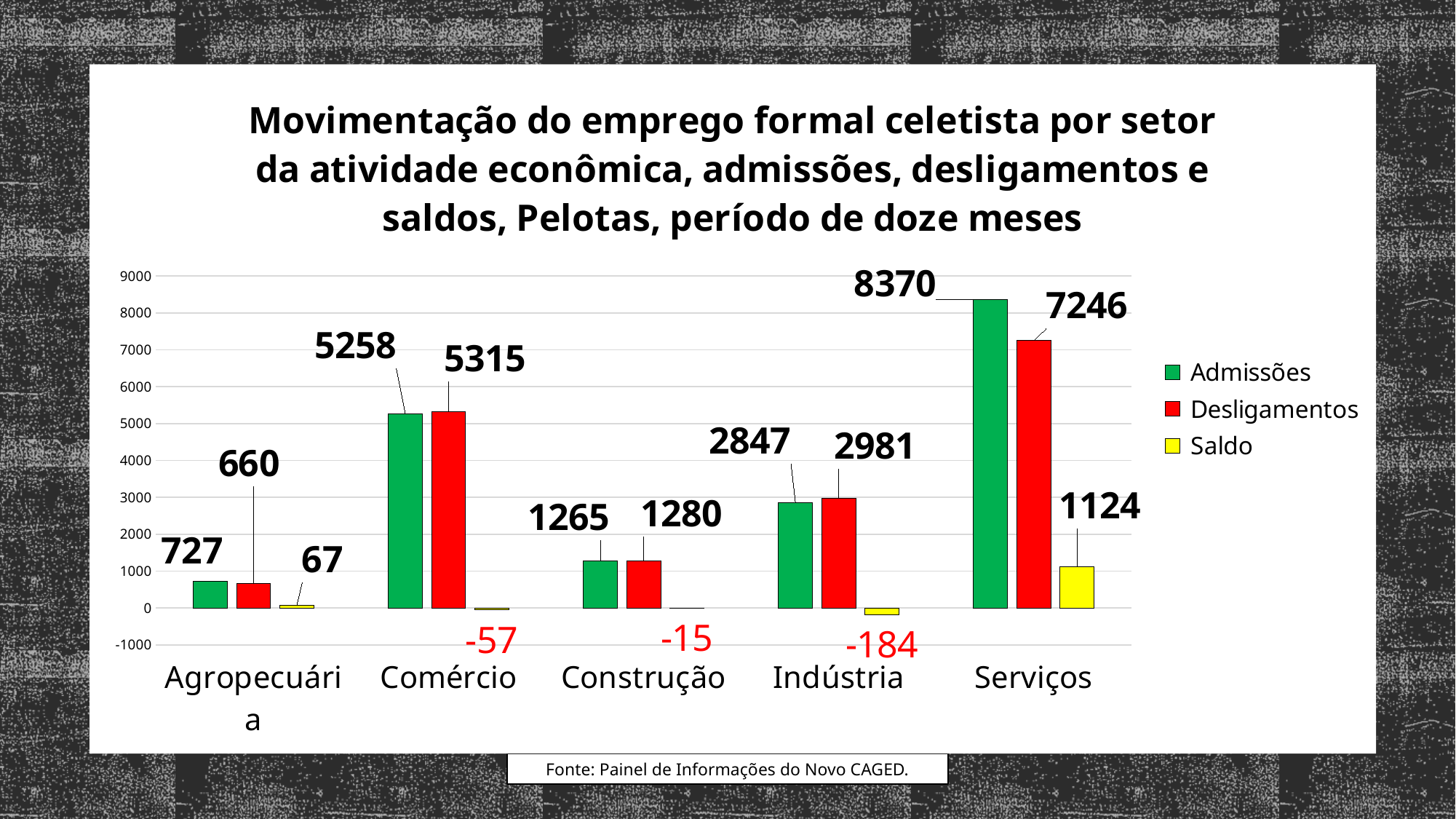
What is the difference between Admissões and Desligamentos for Serviços? 1124 Which sector has the highest Admissões value? Serviços What is the Desligamentos value for Comércio? 5315 How many sectors are shown on the x axis? 5 Is the Admissões value for Indústria greater or less than 2000? greater What is the Saldo value for Indústria? -184 Which is larger for Construção, Admissões or Desligamentos? Desligamentos Which sector has the lowest Desligamentos value? Agropecuária How many series does the legend list? 3 What colour represents the Saldo series in the legend? yellow What kind of chart is shown on the slide? bar chart What is the Admissões value for Serviços? 8370